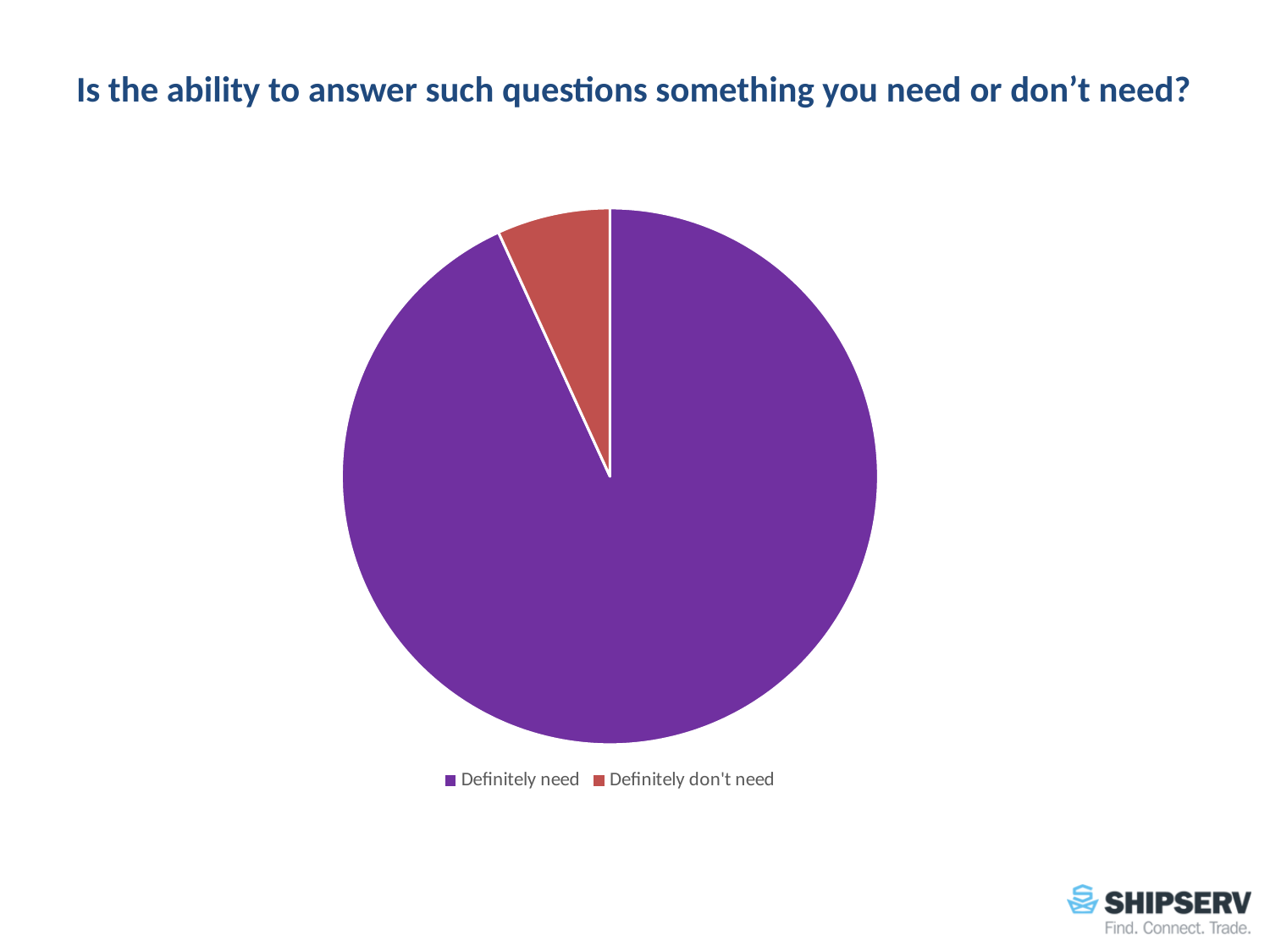
What colour is the slice for Definitely don't need? red How many entries does the legend list? 2 Which slice is the largest in the pie chart? Definitely need Which is larger, the slice for Definitely need or the slice for Definitely don't need? Definitely need Which slice is the smallest in the pie chart? Definitely don't need What kind of chart is shown on the slide? pie chart How many slices does the pie chart have? 2 What is the title of the chart? Is the ability to answer such questions something you need or don't need?